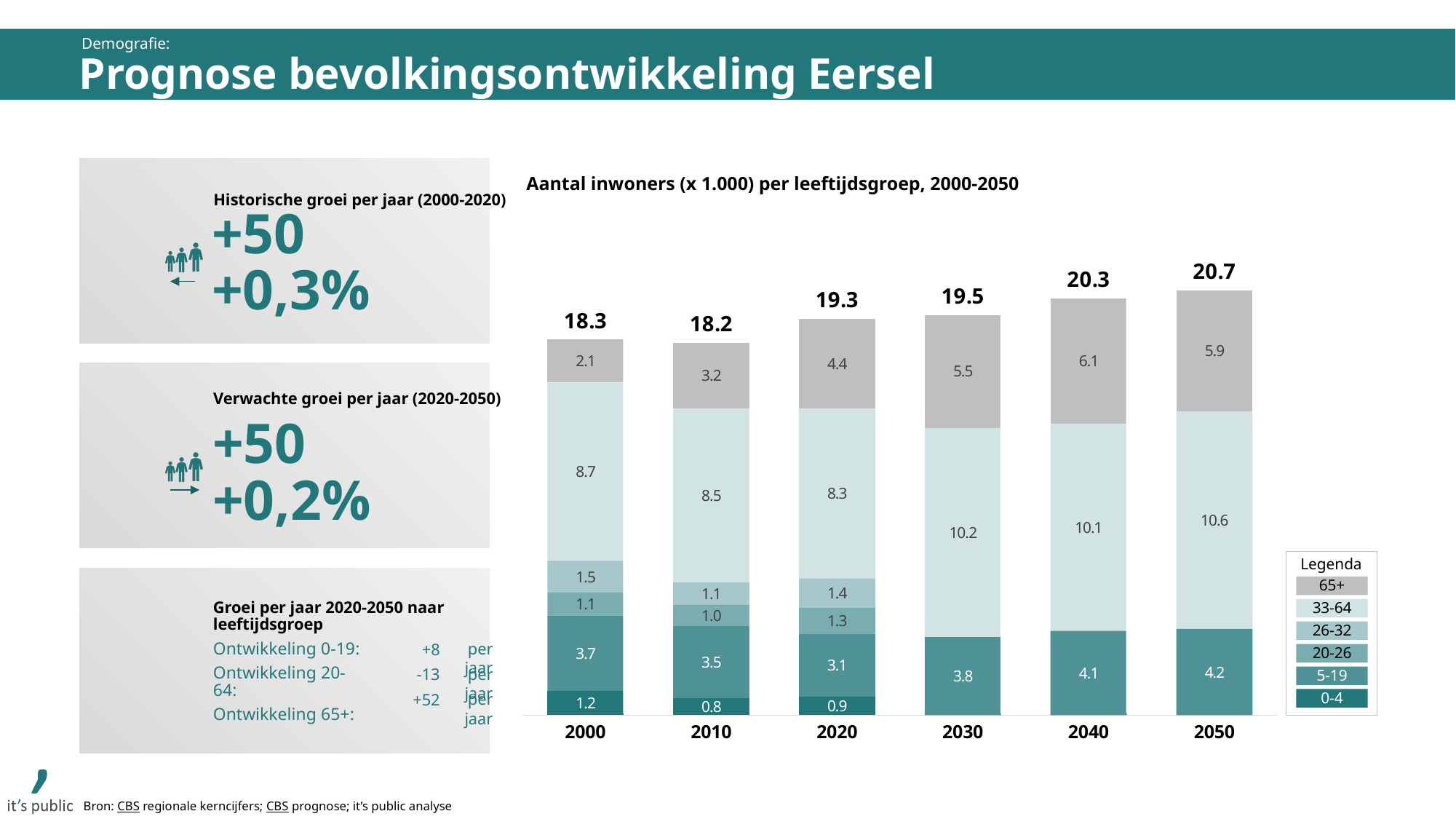
Which year has the larger value for the 33-64 age group, 2020 or 2030? 2030 What kind of chart is shown on the slide? Stacked bar chart How many age groups does the legend list? 6 How many years are shown along the x axis of the chart? 6 Which year has the lowest total number of inhabitants? 2010 Which year has the highest total number of inhabitants? 2050 What is the value for the 65+ age group in 2020? 4.4 What is the value for the 33-64 age group in 2000? 8.7 Does the value for the 65+ age group rise or fall from 2000 to 2040? Rise By how much does the 65+ value in 2040 exceed the 65+ value in 2000? 4.0 What is the total number of inhabitants (x 1.000) shown for 2050? 20.7 What is the value for the 0-4 age group in 2010? 0.8